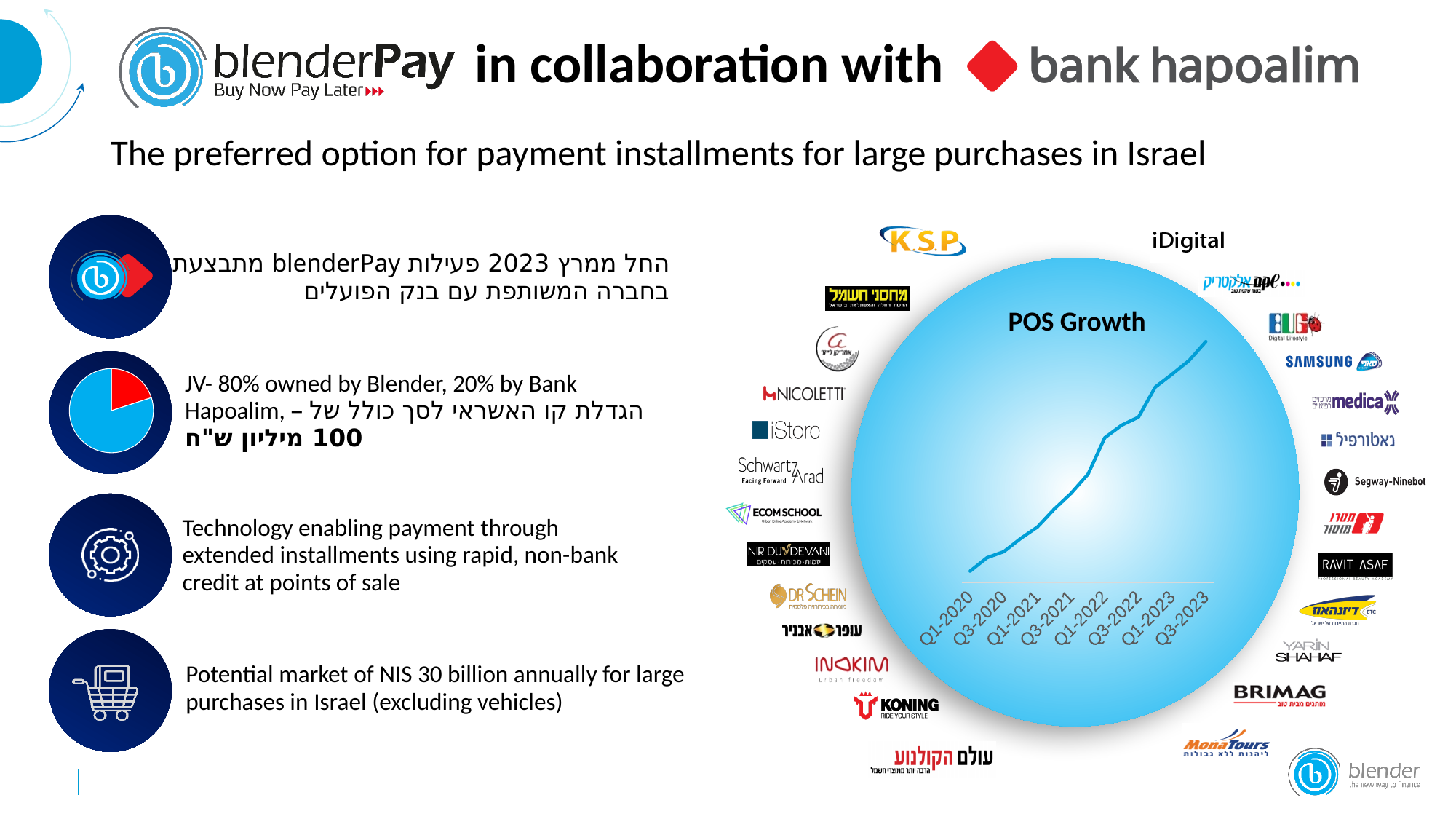
In the "POS Growth" chart, which quarter has the lowest value? Q1-2020 In the "POS Growth" chart, do the values rise or fall from Q1-2020 to Q3-2023? rise What kind of chart is the "POS Growth" chart? line chart In the small pie chart on the left of the slide, what share of the JV is owned by Bank Hapoalim? 20% What is the last quarter label on the x axis of the "POS Growth" chart? Q3-2023 In the "POS Growth" chart, which is larger: the value for Q3-2020 or the value for Q3-2022? Q3-2022 What is the first quarter label on the x axis of the "POS Growth" chart? Q1-2020 In the "POS Growth" chart, is the value for Q1-2022 larger or smaller than the value for Q1-2021? larger How many lines are plotted in the "POS Growth" chart? 1 How many quarter labels are shown on the x axis of the "POS Growth" chart? 8 In the "POS Growth" chart, which quarter has the highest value? Q3-2023 What is the title of the chart on the right side of the slide? POS Growth